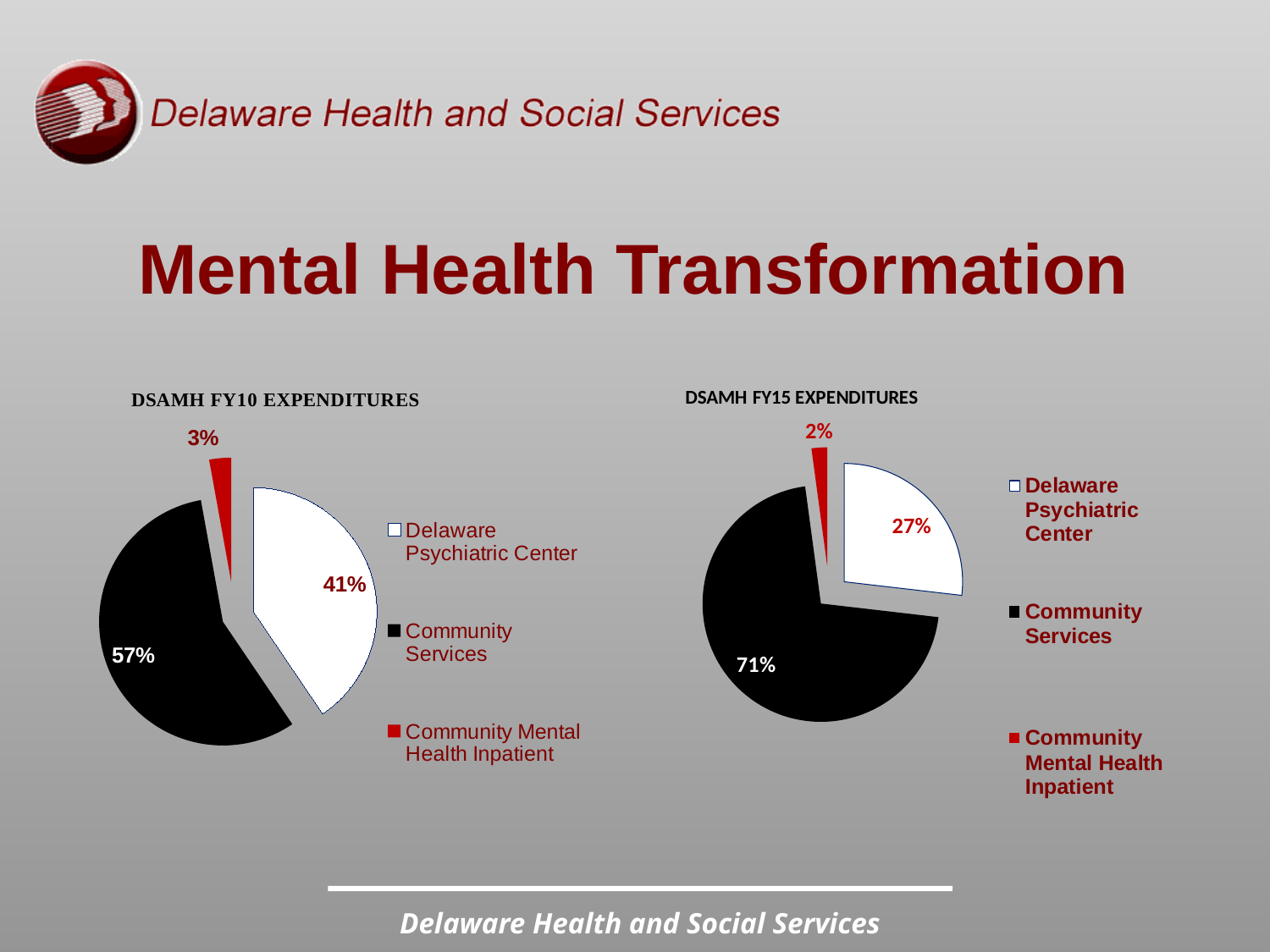
In the DSAMH FY15 EXPENDITURES chart, what share of expenditures goes to Delaware Psychiatric Center? 27% In the DSAMH FY15 EXPENDITURES chart, what share of expenditures goes to Community Services? 71% What kind of chart is the DSAMH FY10 EXPENDITURES chart? Pie chart In the DSAMH FY15 EXPENDITURES chart, which is larger: the Delaware Psychiatric Center share or the Community Services share? Community Services In the DSAMH FY15 EXPENDITURES chart, which category has the smallest share? Community Mental Health Inpatient In the DSAMH FY15 EXPENDITURES chart, what share of expenditures goes to Community Mental Health Inpatient? 2% In the DSAMH FY10 EXPENDITURES chart, which category has the largest share? Community Services How many categories does the DSAMH FY15 EXPENDITURES chart show? 3 In the DSAMH FY10 EXPENDITURES chart, what is the difference between the Community Services share and the Delaware Psychiatric Center share? 16%